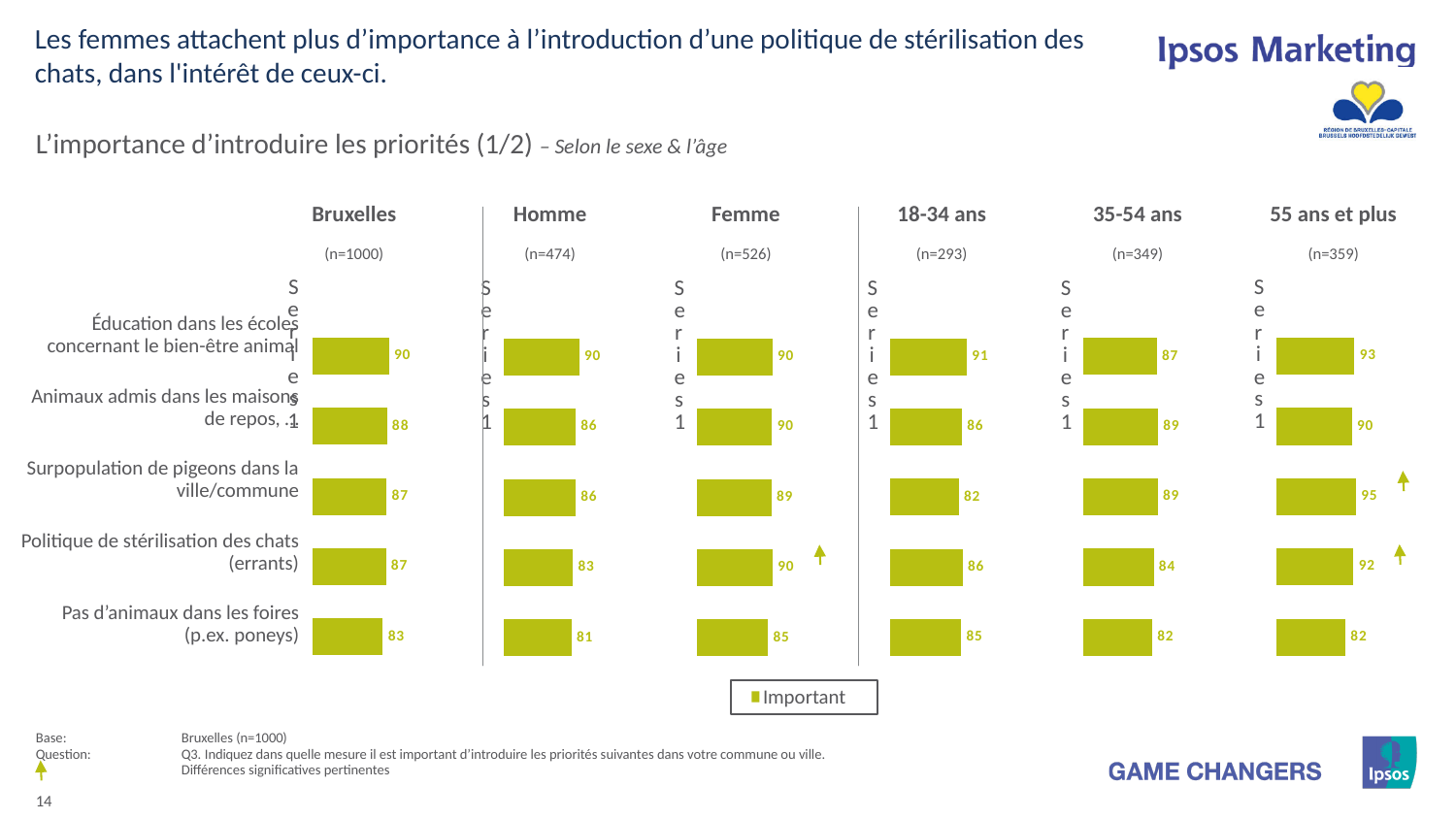
Which is larger: the 55 ans et plus value or the 18-34 ans value for "Surpopulation de pigeons dans la ville/commune"? 55 ans et plus In the Femme chart, what is the value for "Politique de stérilisation des chats (errants)"? 90 What type of chart is used for the Femme group? Bar chart In the Homme chart, which category has the lowest value? Pas d'animaux dans les foires (p.ex. poneys) What is the single legend entry shown below the charts? Important In the Homme chart, what is the value for "Pas d'animaux dans les foires (p.ex. poneys)"? 81 In the 55 ans et plus chart, which category has the highest value? Surpopulation de pigeons dans la ville/commune What is the difference between the Femme and Homme values for "Politique de stérilisation des chats (errants)"? 7 How many categories are shown in the Bruxelles chart? 5 In the Bruxelles chart, what is the value for "Éducation dans les écoles concernant le bien-être animal"? 90 In the 18-34 ans chart, which category has the lowest value? Surpopulation de pigeons dans la ville/commune In the 35-54 ans chart, what is the difference between "Animaux admis dans les maisons de repos" and "Pas d'animaux dans les foires (p.ex. poneys)"? 7